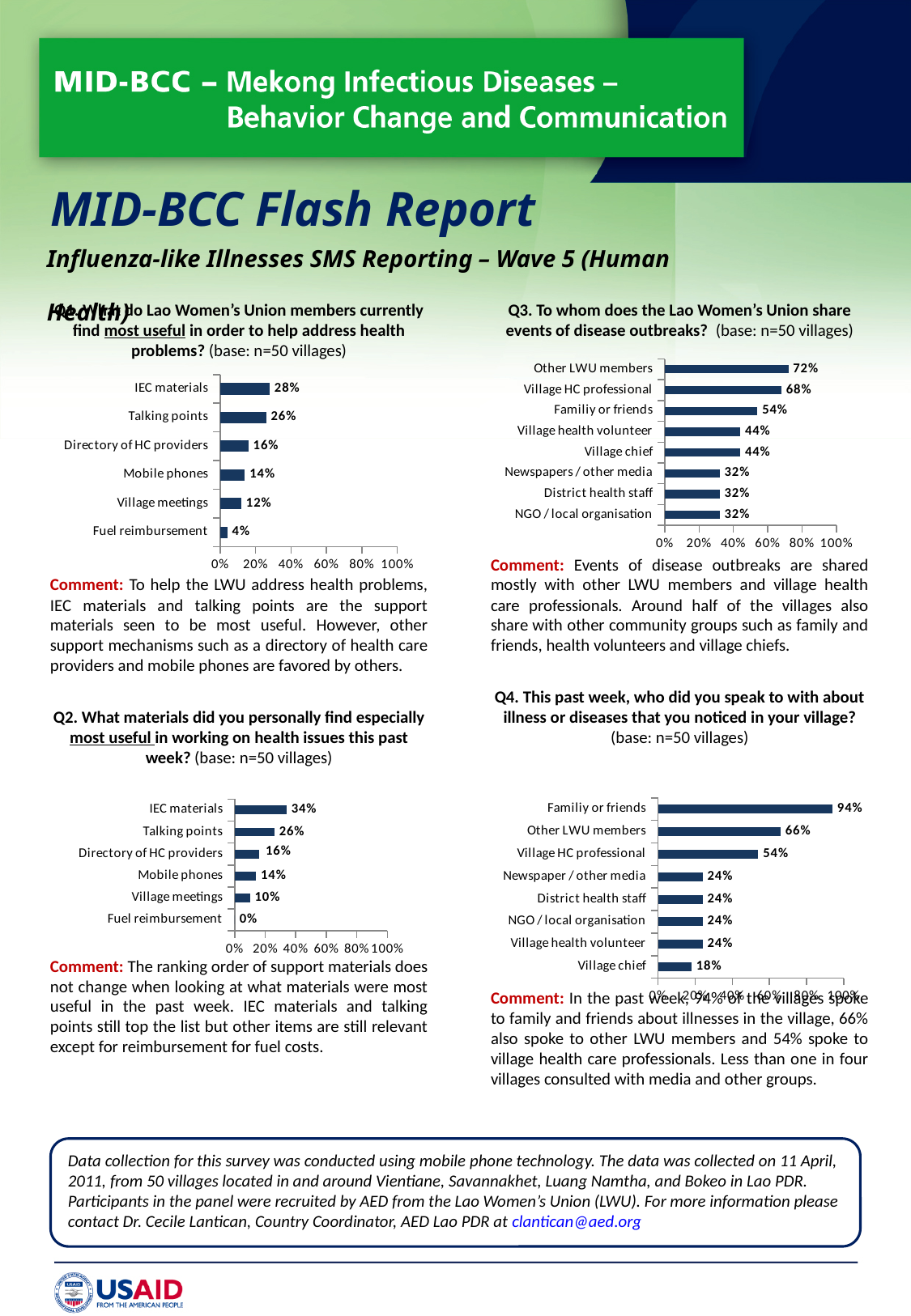
In the Q2 chart (bottom left), what is the value for Fuel reimbursement? 0% In the Q4 chart (bottom right), what is the value for Familiy or friends? 94% In the Q1 chart (top left), what percentage of villages find IEC materials most useful? 28% In the Q2 chart (bottom left), what is the difference between IEC materials and Talking points? 8% In the Q1 chart (top left), how many categories are plotted? 6 In the Q3 chart (top right), what percentage of villages share outbreak events with Village HC professionals? 68% In the Q1 chart (top left), which category has the lowest value? Fuel reimbursement In the Q2 chart (bottom left), which category has the highest value? IEC materials In the Q4 chart (bottom right), which is larger: Other LWU members or Village HC professional? Other LWU members In the Q3 chart (top right), which category has the highest value? Other LWU members What type of chart is the Q4 chart (bottom right)? Bar chart In the Q3 chart (top right), how many categories are plotted? 8